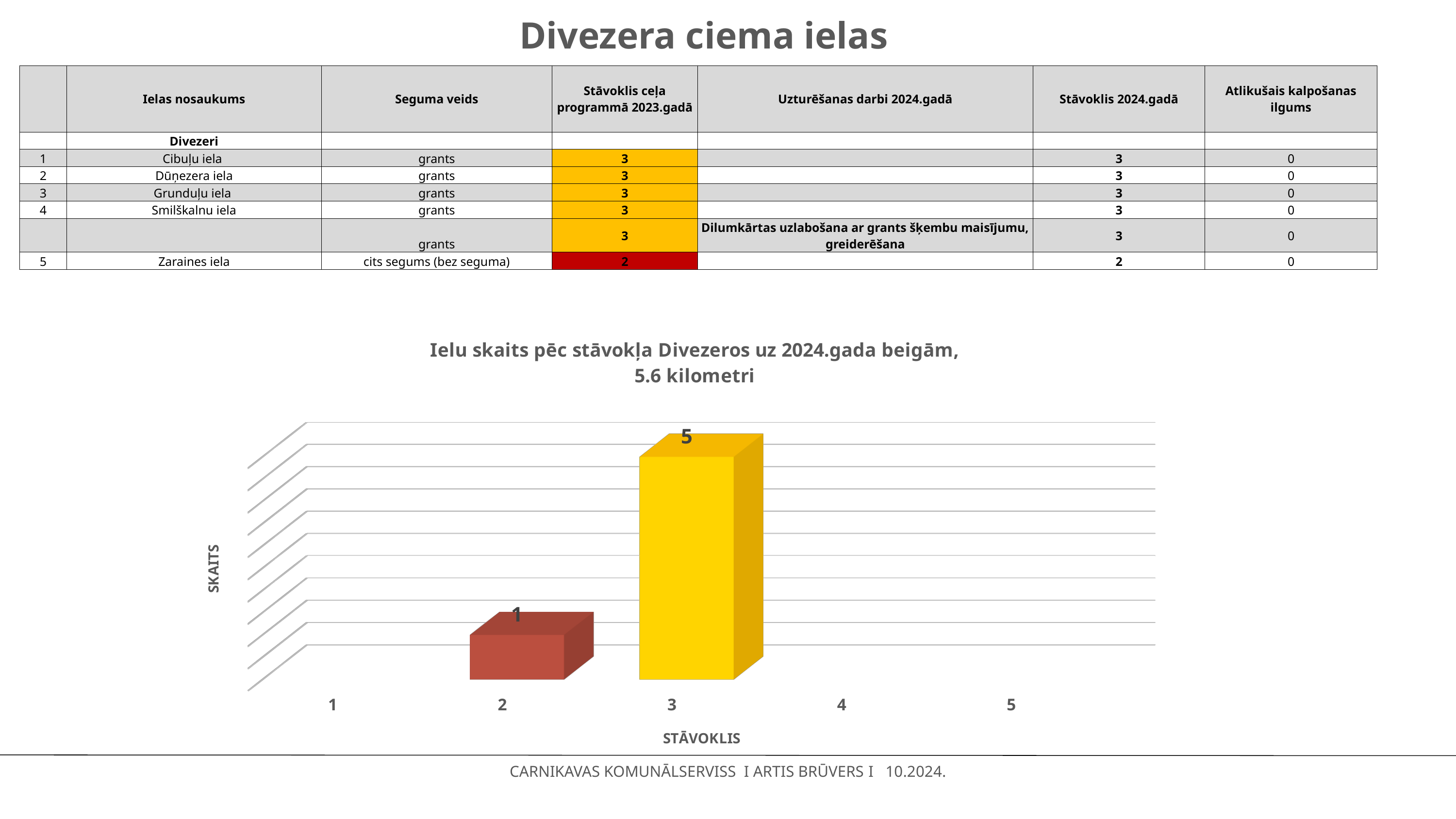
How many condition categories are shown on the x axis of the chart? 5 What is the difference between the values for condition categories 3 and 2? 4 What is the title of the chart? Ielu skaits pēc stāvokļa Divezeros uz 2024.gada beigām, 5.6 kilometri What kind of chart is shown on the slide? Bar chart How many condition categories in the chart have a visible bar? 2 Which condition category has the highest number of streets in the chart? 3 What is the value for condition category 2 in the chart? 1 What is the label of the x axis of the chart? STĀVOKLIS What is the value for condition category 3 in the chart? 5 Which is larger, the value for condition category 2 or condition category 3? 3